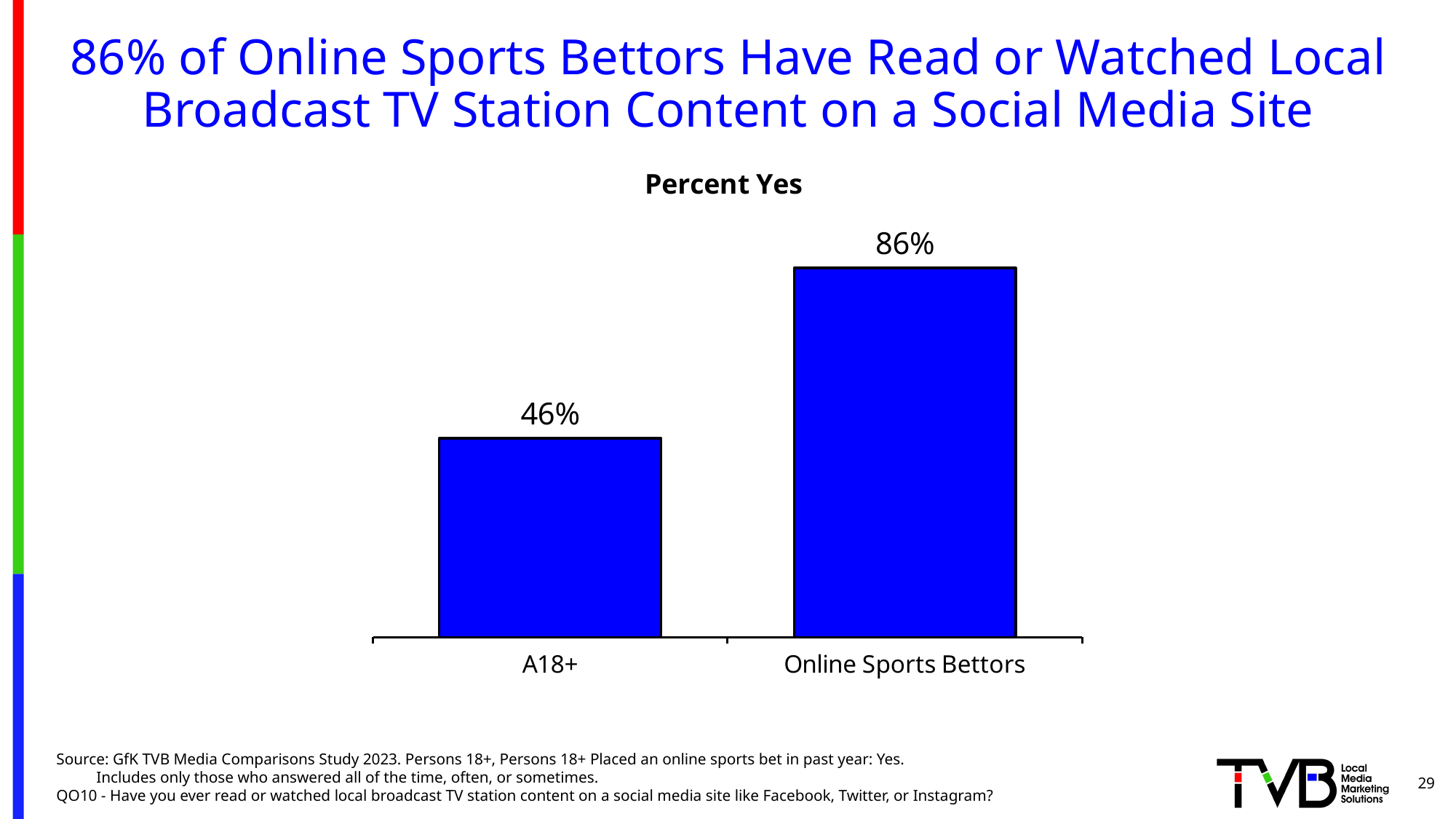
Which category has the highest Percent Yes value? Online Sports Bettors What is the Percent Yes value for A18+? 46% What is the title of the chart? Percent Yes What is the Percent Yes value for Online Sports Bettors? 86% What colour are the bars in the chart? Blue What is the difference in Percent Yes between Online Sports Bettors and A18+? 40% What kind of chart is shown on the slide? Bar chart Which is larger, the Percent Yes value for A18+ or for Online Sports Bettors? Online Sports Bettors How many categories are shown in the chart? 2 Which category has the lowest Percent Yes value? A18+